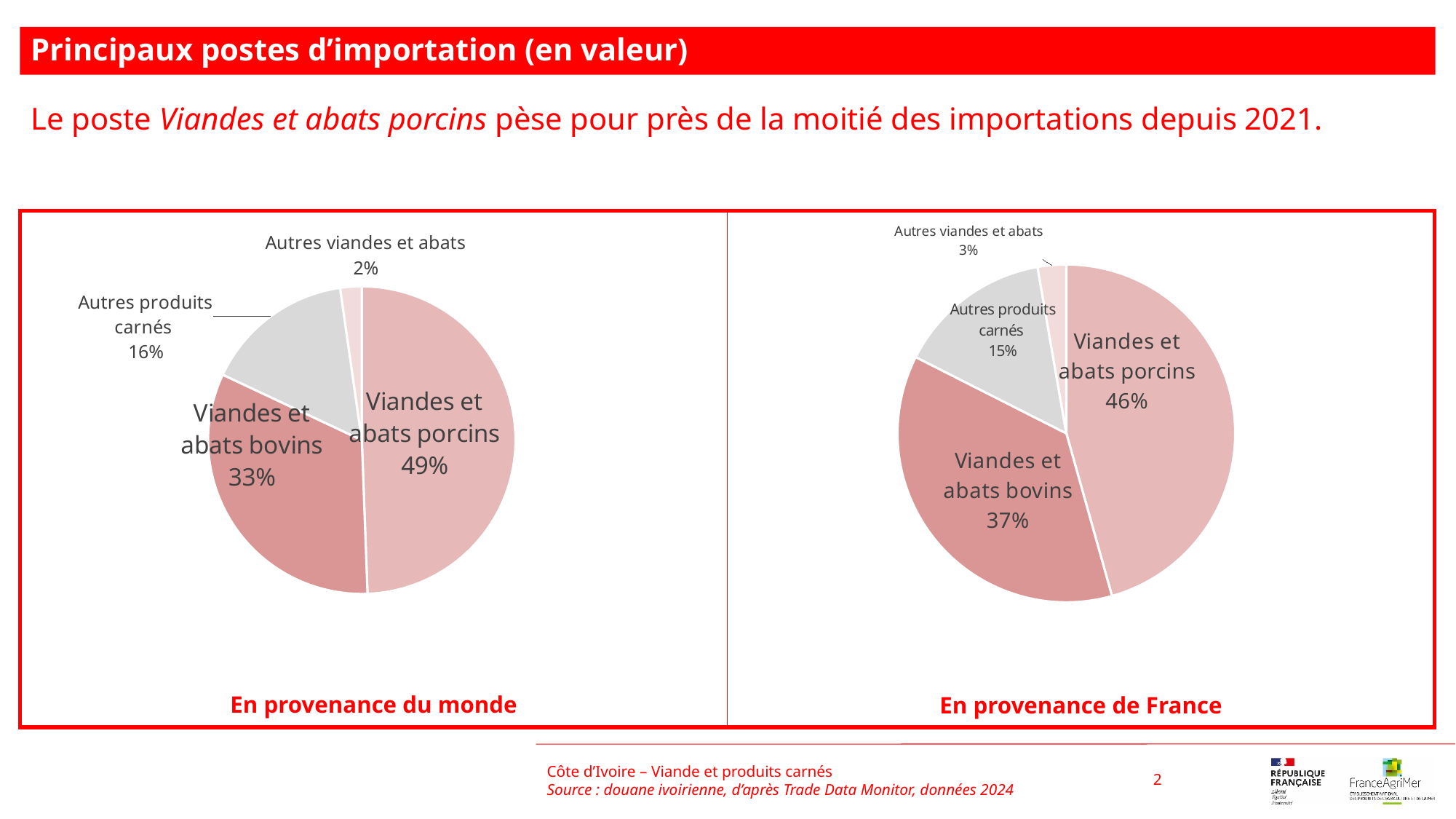
In the 'En provenance de France' pie chart, what share does 'Viandes et abats bovins' have? 37% In the 'En provenance de France' pie chart, what is the difference between the shares of 'Viandes et abats porcins' and 'Autres produits carnés'? 31 percentage points In the 'En provenance du monde' pie chart, which category has the largest share? Viandes et abats porcins In the 'En provenance du monde' pie chart, what is the difference between the shares of 'Viandes et abats porcins' and 'Viandes et abats bovins'? 16 percentage points In the 'En provenance du monde' pie chart, what is the value for 'Autres produits carnés'? 16% What is the title of the chart on the left side of the slide? En provenance du monde In the 'En provenance du monde' pie chart, what share does 'Viandes et abats porcins' have? 49% Is the share of 'Viandes et abats bovins' larger in the 'En provenance du monde' chart or in the 'En provenance de France' chart? En provenance de France In the 'En provenance de France' pie chart, which category has the smallest share? Autres viandes et abats In the 'En provenance de France' pie chart, what is the value for 'Autres viandes et abats'? 3% What type of chart is used for 'En provenance de France'? Pie chart How many categories are shown in the 'En provenance du monde' pie chart? 4